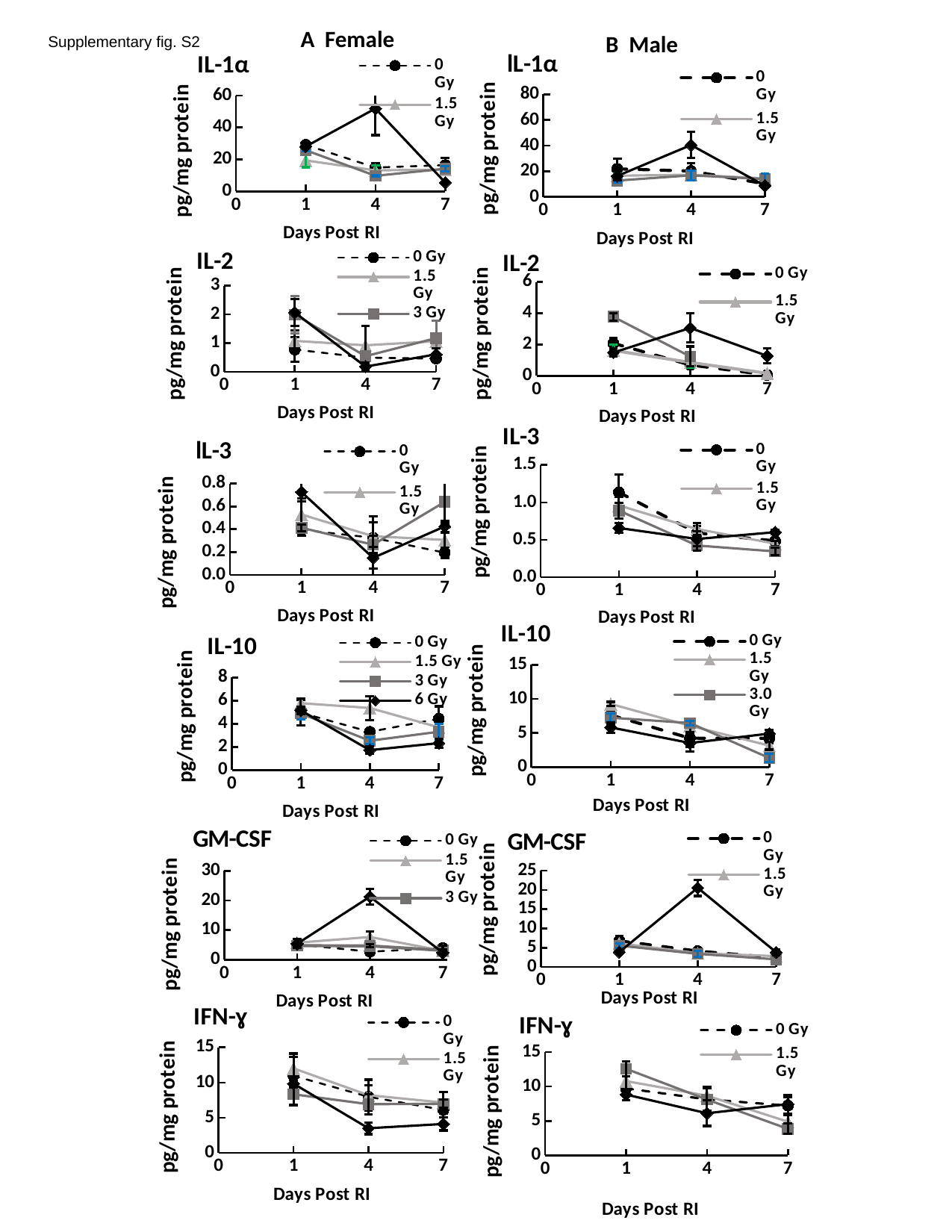
In the Male IL-2 chart, is the highest value plotted at day 1 greater or less than 2? greater In the Female IL-10 chart, at which day is the 0 Gy value lowest? 4 In the Male IL-3 chart, at which day is the 0 Gy value highest? 1 How many series does the legend of the Female IL-10 chart list? 4 How many series does the legend of the Male IL-10 chart list? 3 In the Male IFN-γ chart, does the 1.5 Gy series rise or fall from day 1 to day 7? fall In the Female IL-1α chart, is the highest value plotted at day 4 greater or less than 40? greater In the Male IFN-γ chart, is the 0 Gy value larger at day 1 or at day 4? day 1 What kind of chart is the Female IL-10 chart? line chart How many time points (days post RI) are plotted in the Male IL-3 chart? 3 What is the x-axis label of the Female GM-CSF chart? Days Post RI In the Male GM-CSF chart, does the 0 Gy series rise or fall from day 1 to day 7? fall